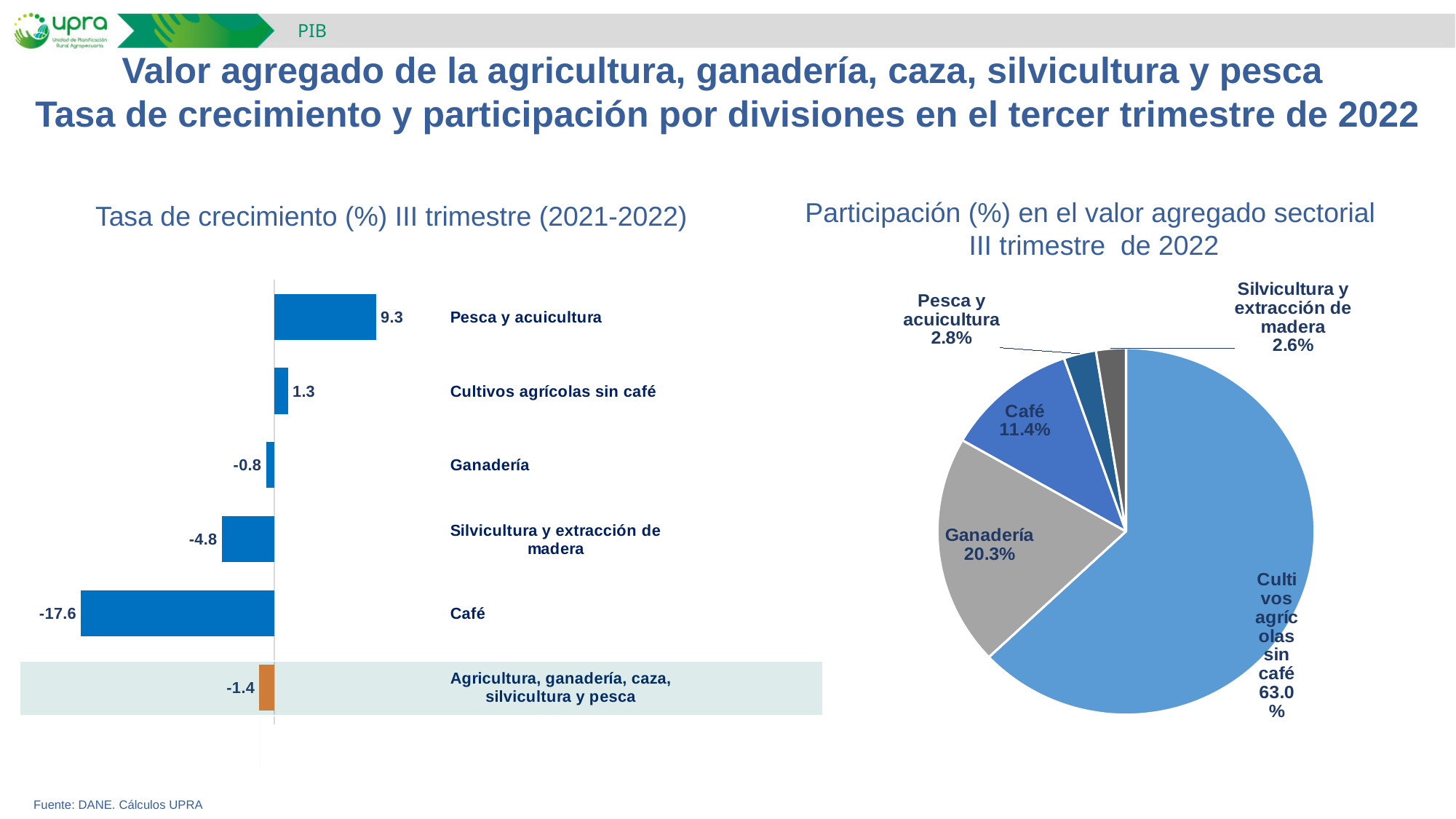
In the 'Tasa de crecimiento (%) III trimestre (2021-2022)' chart, which category has the lowest growth rate? Café In the 'Tasa de crecimiento (%) III trimestre (2021-2022)' chart, what is the growth rate for Pesca y acuicultura? 9.3 In the 'Tasa de crecimiento (%) III trimestre (2021-2022)' chart, what is the growth rate for Café? -17.6 In the 'Tasa de crecimiento (%) III trimestre (2021-2022)' chart, what is the difference between the values for Pesca y acuicultura and Cultivos agrícolas sin café? 8.0 In the 'Tasa de crecimiento (%) III trimestre (2021-2022)' chart, which is larger, the value for Ganadería or the value for Silvicultura y extracción de madera? Ganadería What kind of chart is the 'Participación (%) en el valor agregado sectorial III trimestre de 2022' chart? Pie chart In the 'Tasa de crecimiento (%) III trimestre (2021-2022)' chart, which category has the highest growth rate? Pesca y acuicultura In the 'Participación (%) en el valor agregado sectorial III trimestre de 2022' chart, which category has the largest share? Cultivos agrícolas sin café In the 'Tasa de crecimiento (%) III trimestre (2021-2022)' chart, what is the value for Agricultura, ganadería, caza, silvicultura y pesca? -1.4 What kind of chart is the 'Tasa de crecimiento (%) III trimestre (2021-2022)' chart? Bar chart In the 'Participación (%) en el valor agregado sectorial III trimestre de 2022' chart, what share does Ganadería have? 20.3% How many categories are shown in the 'Tasa de crecimiento (%) III trimestre (2021-2022)' chart? 6